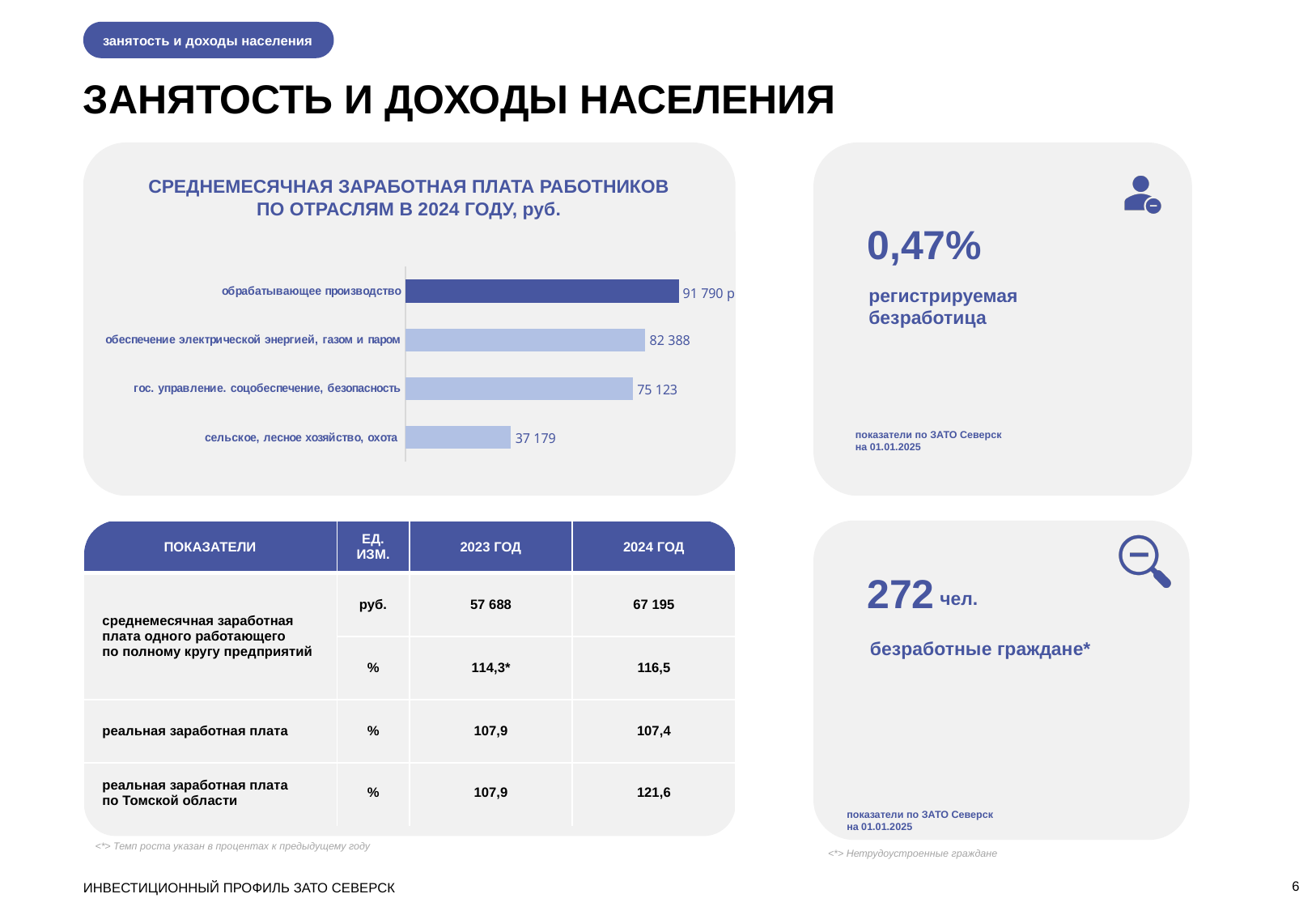
What is the value for обеспечение электрической энергией, газом и паром in the chart? 82 388 What type of chart is shown on the slide? bar chart What is the title of the chart on the slide? СРЕДНЕМЕСЯЧНАЯ ЗАРАБОТНАЯ ПЛАТА РАБОТНИКОВ ПО ОТРАСЛЯМ В 2024 ГОДУ, руб. How many industries are shown in the chart? 4 What is the average monthly salary for обрабатывающее производство in the chart? 91 790 р What is the difference between the values for гос. управление, соцобеспечение, безопасность and сельское, лесное хозяйство, охота? 37 944 Which industry has the highest average monthly salary in the chart? обрабатывающее производство Which is larger: the value for обеспечение электрической энергией, газом и паром or for гос. управление, соцобеспечение, безопасность? обеспечение электрической энергией, газом и паром What is the value for гос. управление, соцобеспечение, безопасность in the chart? 75 123 Which industry has the lowest average monthly salary in the chart? сельское, лесное хозяйство, охота What is the difference between the values for обрабатывающее производство and обеспечение электрической энергией, газом и паром? 9 402 What is the value for сельское, лесное хозяйство, охота in the chart? 37 179